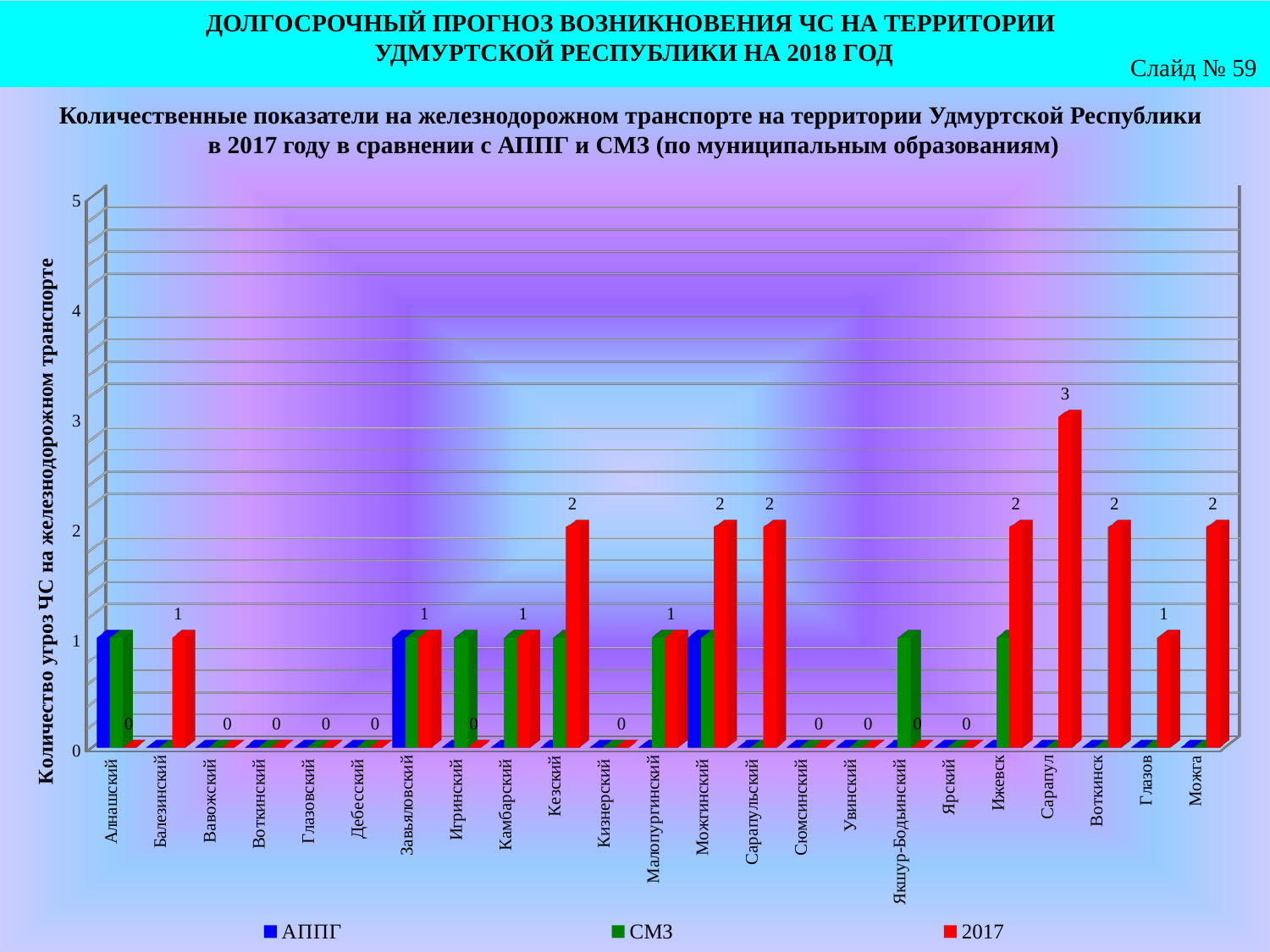
How many categories are shown on the x axis? 23 What is the 2017 value for Балезинский? 1 What colour represents the 2017 series in the legend? red Which has the larger 2017 value, Ижевск or Завьяловский? Ижевск Which category has the highest 2017 value? Сарапул What is the difference between the 2017 values for Сарапул and Глазов? 2 What is the 2017 value for Кезский? 2 What kind of chart is shown on the slide? bar chart What is the 2017 value for Ярский? 0 How many series does the legend list? 3 Is the 2017 value for Сарапул greater or less than 2? greater What is the 2017 value for Сарапул? 3